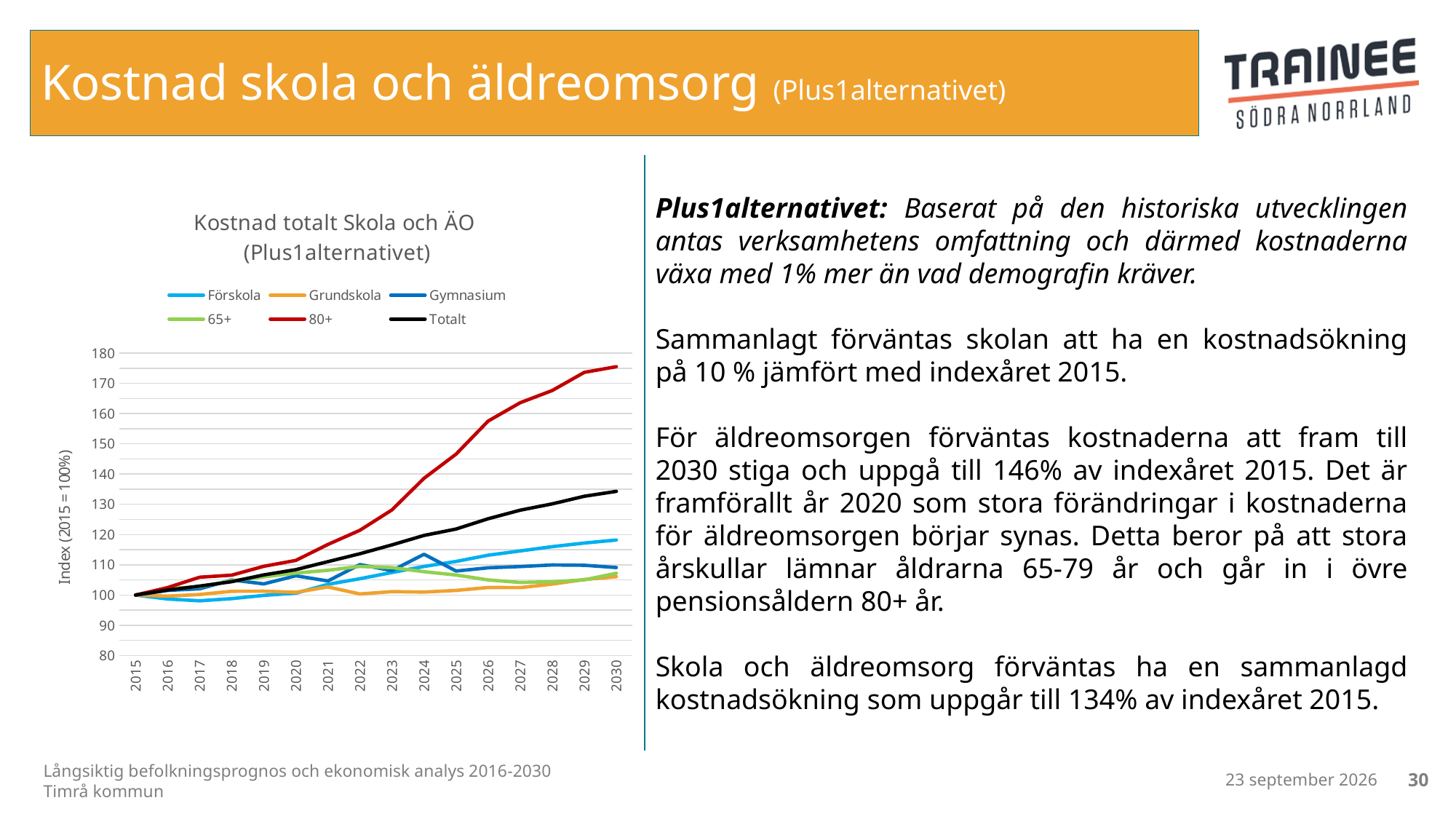
How many series does the chart legend list? 6 In 2030, which is larger, the value for Förskola or the value for Gymnasium? Förskola Is the value for 80+ in 2030 greater or less than 170? greater Is the value for 80+ in 2020 greater or less than 120? less What is the value for Totalt in 2015? 100 How many years are shown along the x axis of the chart? 16 Which series has the highest value in 2030? 80+ Is the value for Totalt in 2030 greater or less than 130? greater Does the 80+ series rise or fall from 2015 to 2030? rise What is the title of the chart? Kostnad totalt Skola och ÄO (Plus1alternativet) What is the label on the y axis of the chart? Index (2015 = 100%) What kind of chart is shown on the slide? line chart